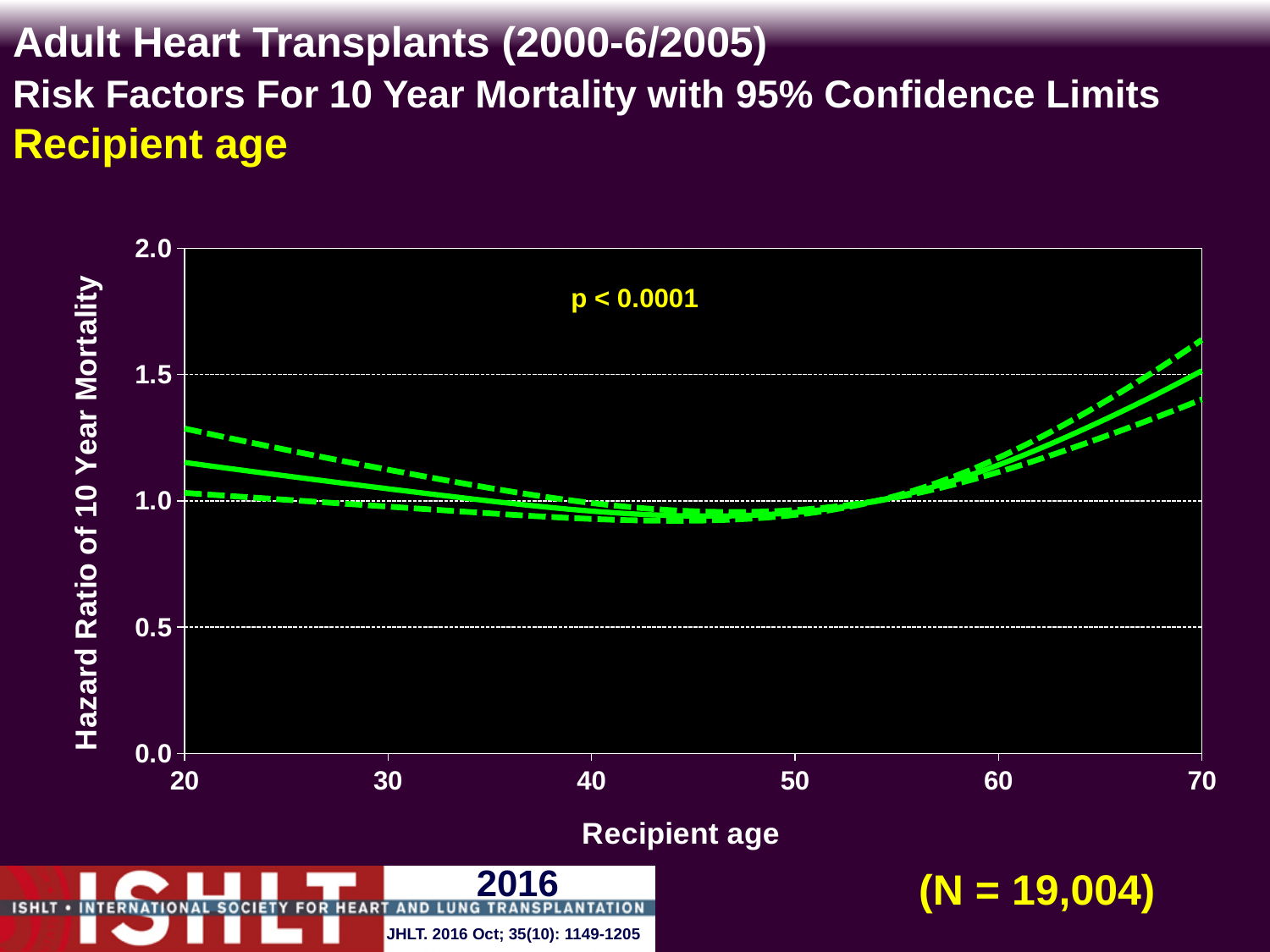
Is the hazard ratio (solid line) at recipient age 60 greater or less than 1.5? less What kind of chart is shown on the slide? line chart Is the hazard ratio (solid line) at recipient age 45 greater or less than 1.0? less What sample size (N) is shown on the slide? N = 19,004 What is the label of the x axis? Recipient age Is the hazard ratio (solid line) at recipient age 20 greater or less than 1.0? greater What p-value is printed on the chart? p < 0.0001 What is the label of the y axis? Hazard Ratio of 10 Year Mortality Does the hazard ratio rise or fall as recipient age increases from 20 to 40? fall What is the highest value shown on the y axis? 2.0 Does the hazard ratio rise or fall as recipient age increases from 50 to 70? rise